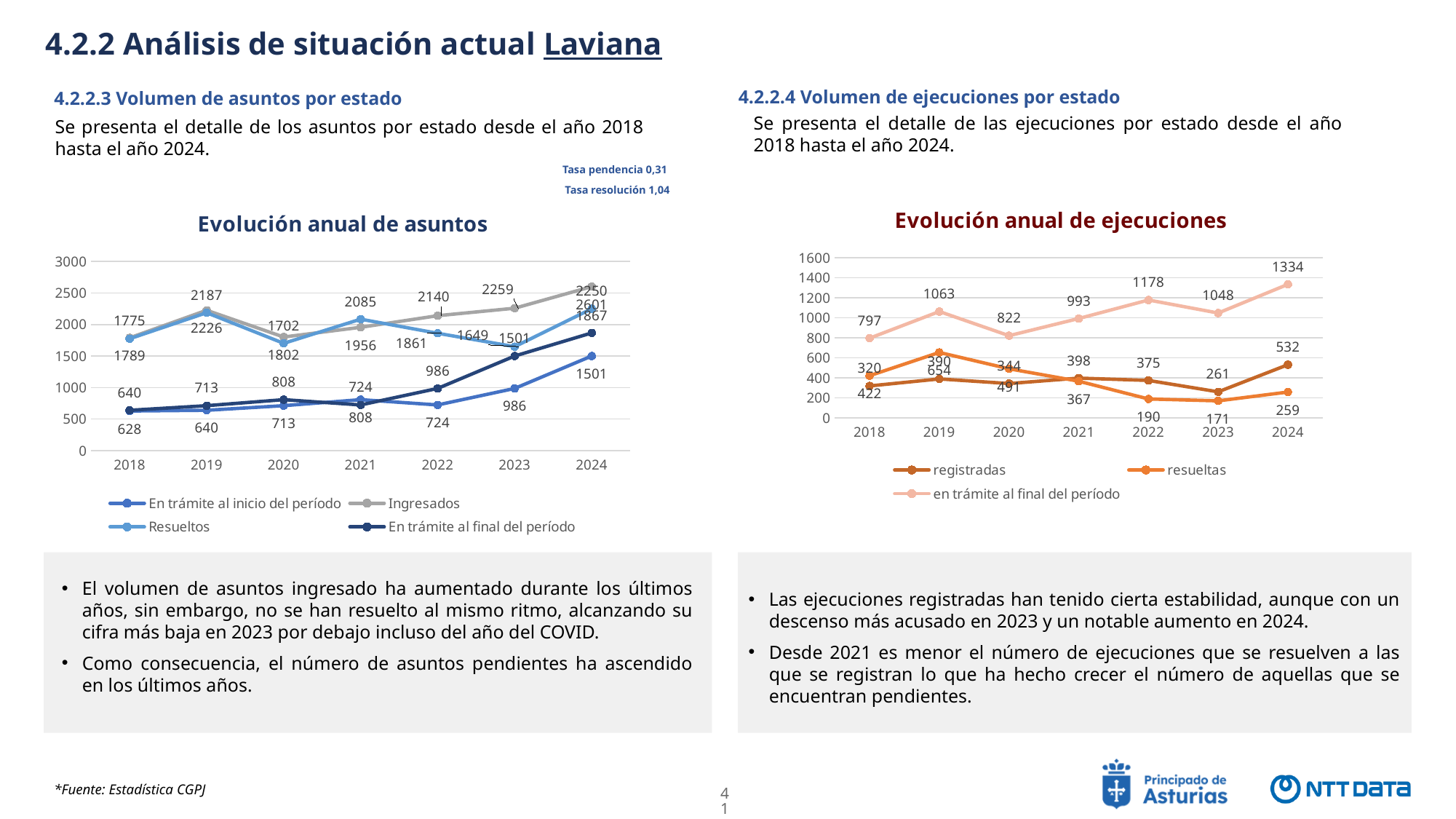
What kind of chart is 'Evolución anual de asuntos'? Line chart In the 'Evolución anual de ejecuciones' chart, what is the value for 'resueltas' in 2019? 654 In the 'Evolución anual de ejecuciones' chart, what is the difference between 'registradas' and 'resueltas' in 2024? 273 In the 'Evolución anual de ejecuciones' chart, how many series does the legend list? 3 In the 'Evolución anual de ejecuciones' chart, what is the value for 'registradas' in 2023? 261 In the 'Evolución anual de ejecuciones' chart, which year has the lowest value for 'resueltas'? 2023 In the 'Evolución anual de asuntos' chart, how many years are shown on the x axis? 7 In the 'Evolución anual de asuntos' chart, what is the value for 'Resueltos' in 2023? 1649 In the 'Evolución anual de asuntos' chart, is the value for 'Ingresados' in 2024 greater or less than 2500? greater In the 'Evolución anual de ejecuciones' chart, what is the value for 'en trámite al final del período' in 2024? 1334 In the 'Evolución anual de ejecuciones' chart, which year has the highest value for 'en trámite al final del período'? 2024 In the 'Evolución anual de asuntos' chart, what is the value for 'En trámite al final del período' in 2024? 1867